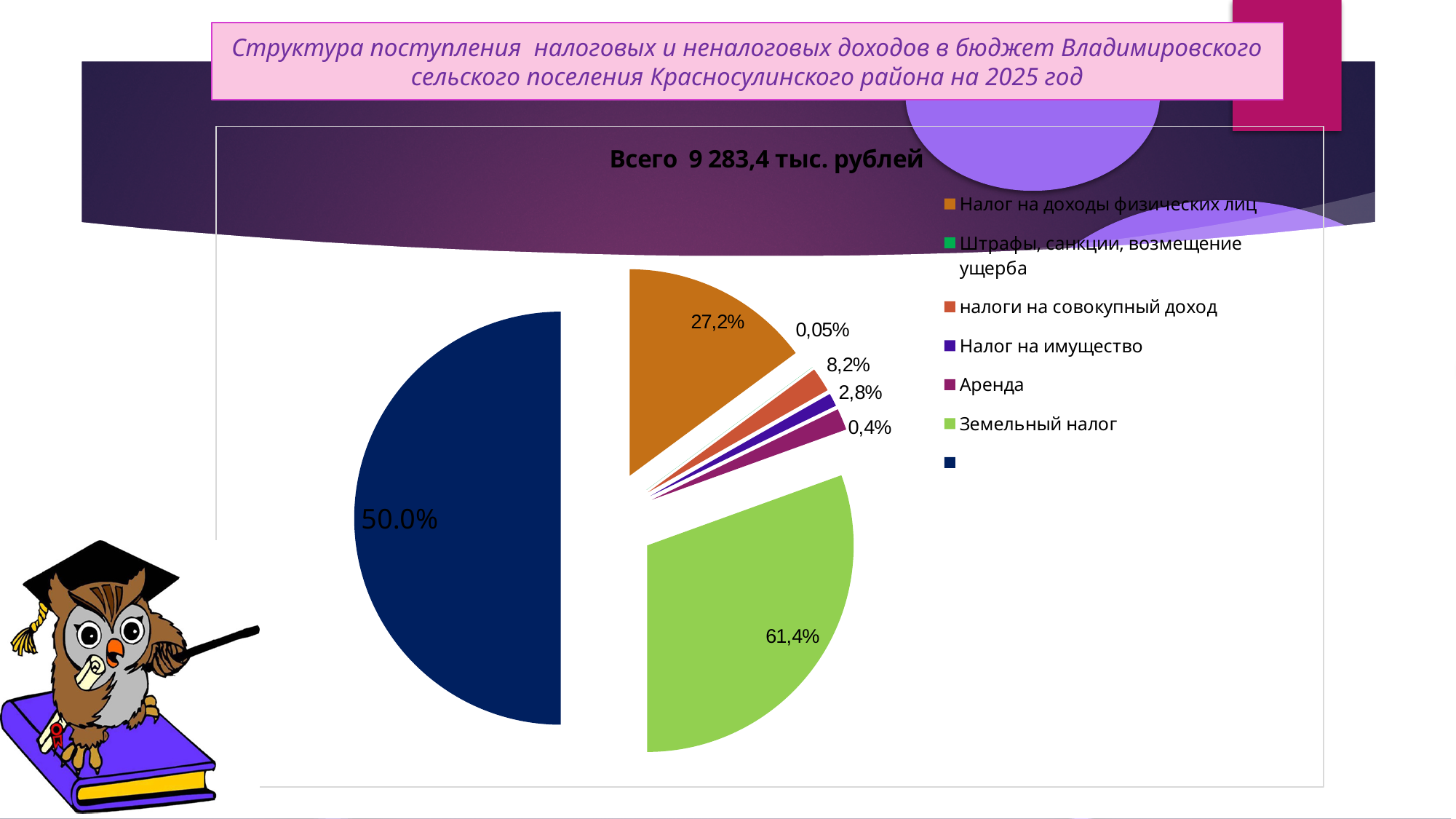
Which named legend category has the smallest percentage? Штрафы, санкции, возмещение ущерба What kind of chart is shown on the slide? pie chart What percentage is shown for Налог на имущество? 2,8% What percentage is shown for налоги на совокупный доход? 8,2% Which named legend category has the largest percentage label? Земельный налог What percentage is shown for Аренда? 0,4% What is the total amount stated in the chart title? 9 283,4 тыс. рублей What percentage is shown for Штрафы, санкции, возмещение ущерба? 0,05% What percentage is shown for Земельный налог? 61,4% What percentage is shown for Налог на доходы физических лиц? 27,2% What is the difference between the percentages for Налог на доходы физических лиц and налоги на совокупный доход? 19,0% Which is larger, the percentage for Налог на имущество or for Аренда? Налог на имущество